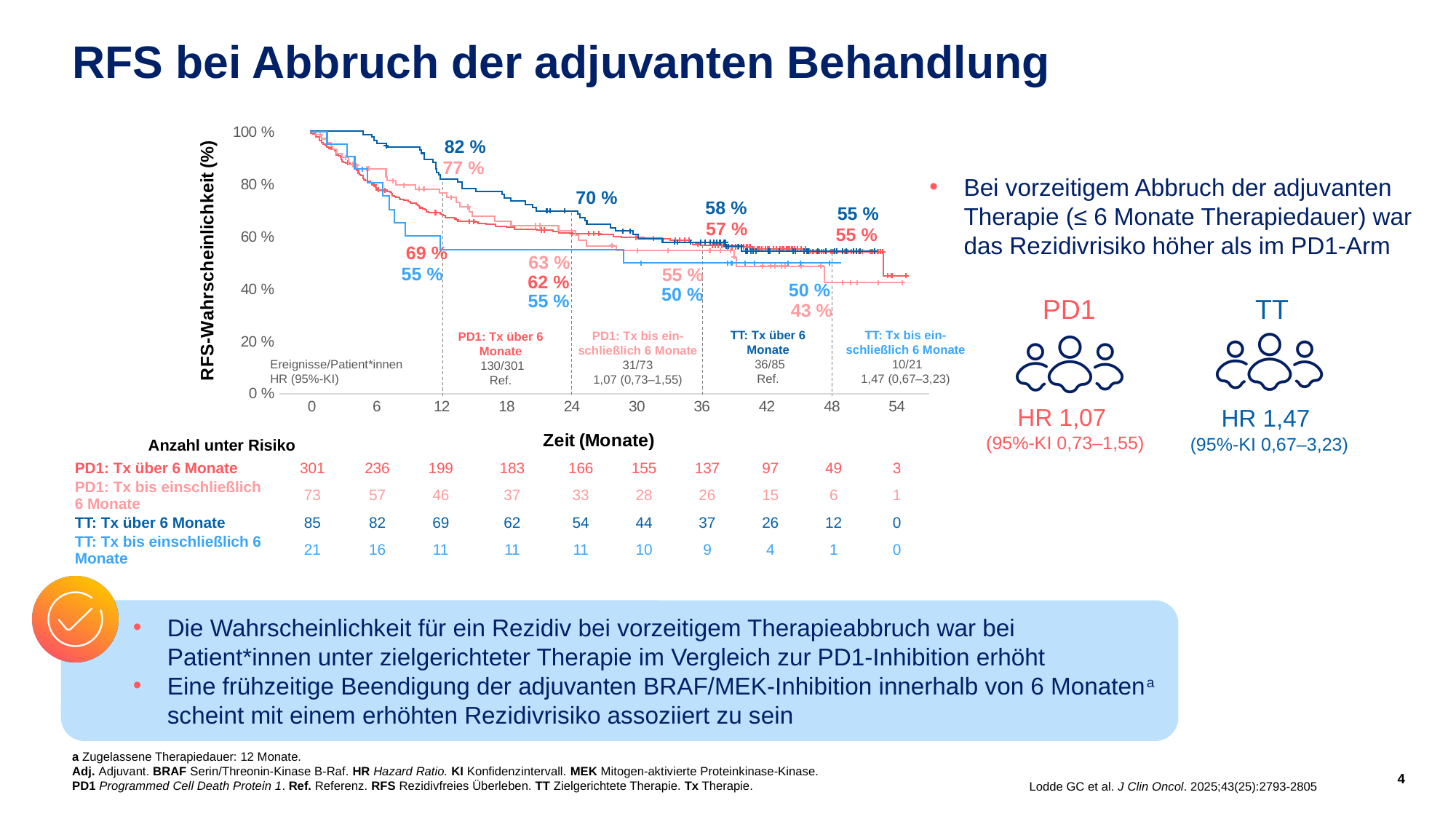
Do the RFS curves rise or fall over time along the x axis? Fall At 24 months, which group has the higher RFS probability: PD1: Tx über 6 Monate or TT: Tx über 6 Monate? TT: Tx über 6 Monate What is the label of the y axis of the chart? RFS-Wahrscheinlichkeit (%) What kind of chart is shown on the slide? Kaplan-Meier survival curve (line chart) What is the RFS probability for the TT: Tx über 6 Monate group at 12 months? 82 % How many patient groups (curves) are plotted in the chart? 4 How many patients in the PD1: Tx über 6 Monate group were at risk at 0 months? 301 What is the hazard ratio (95%-KI) for the TT: Tx bis einschließlich 6 Monate group? 1,47 (0,67–3,23) Which group has the lowest RFS probability at 48 months? PD1: Tx bis einschließlich 6 Monate Which group has the highest RFS probability at 12 months? TT: Tx über 6 Monate What is the RFS probability for the TT: Tx bis einschließlich 6 Monate group at 48 months? 50 % What is the difference between the 12-month RFS probability of TT: Tx über 6 Monate (82 %) and TT: Tx bis einschließlich 6 Monate (55 %)? 27 %